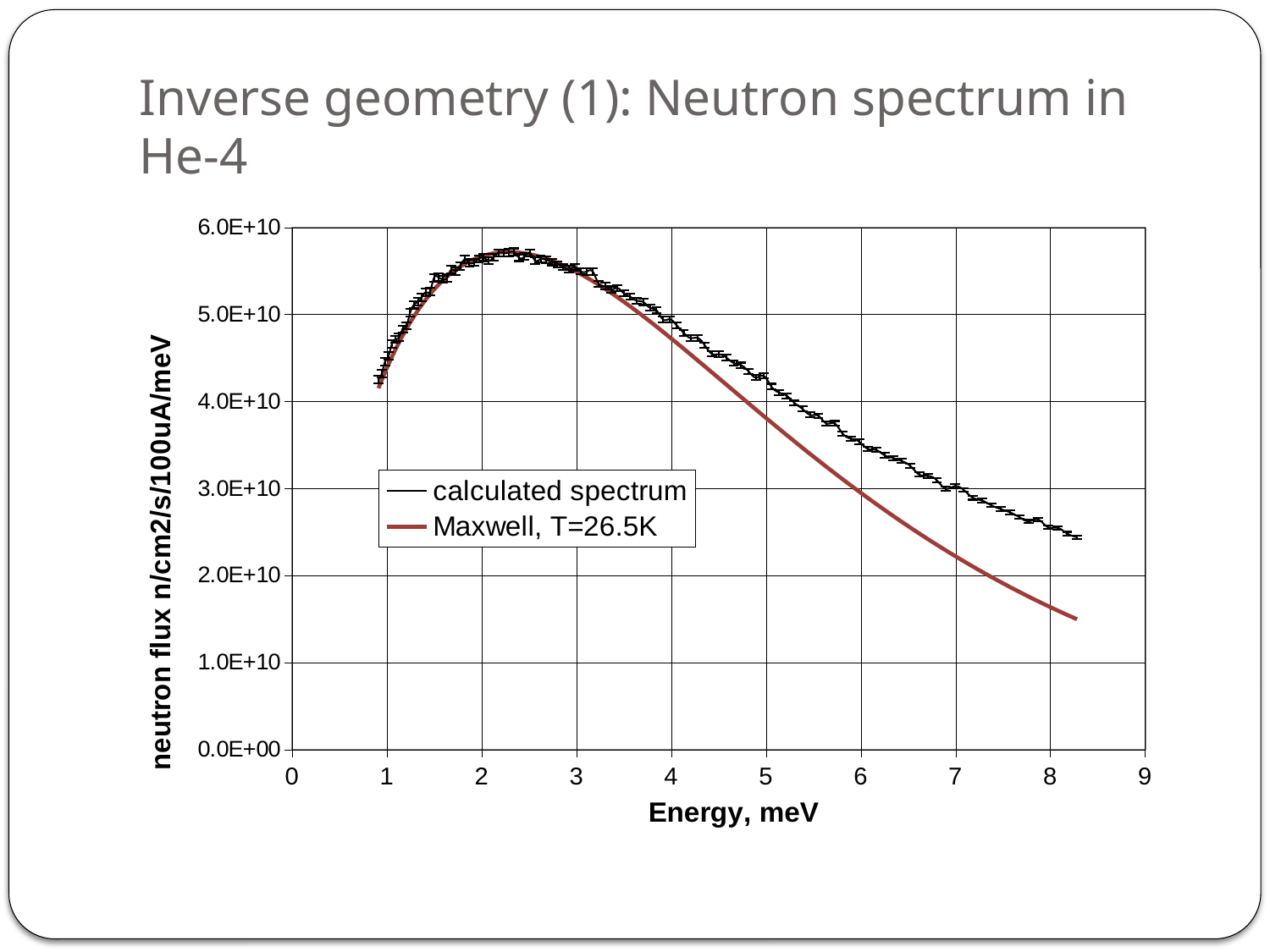
What kind of chart is shown on the slide? line chart Is the value of the Maxwell, T=26.5K curve at 5 meV greater or less than 4.0E+10? less At 8 meV, which series has the higher neutron flux, the calculated spectrum or the Maxwell, T=26.5K curve? calculated spectrum Is the peak value of the calculated spectrum greater or less than 5.0E+10? greater What is the title of the x axis? Energy, meV Do the values of the Maxwell, T=26.5K curve rise or fall as energy increases from 3 meV to 8 meV? fall What are the two series named in the legend? calculated spectrum; Maxwell, T=26.5K Is the value of the calculated spectrum at 6 meV greater or less than 3.0E+10? greater How many series does the legend list? 2 At 7 meV, which series has the higher neutron flux, the calculated spectrum or the Maxwell, T=26.5K curve? calculated spectrum